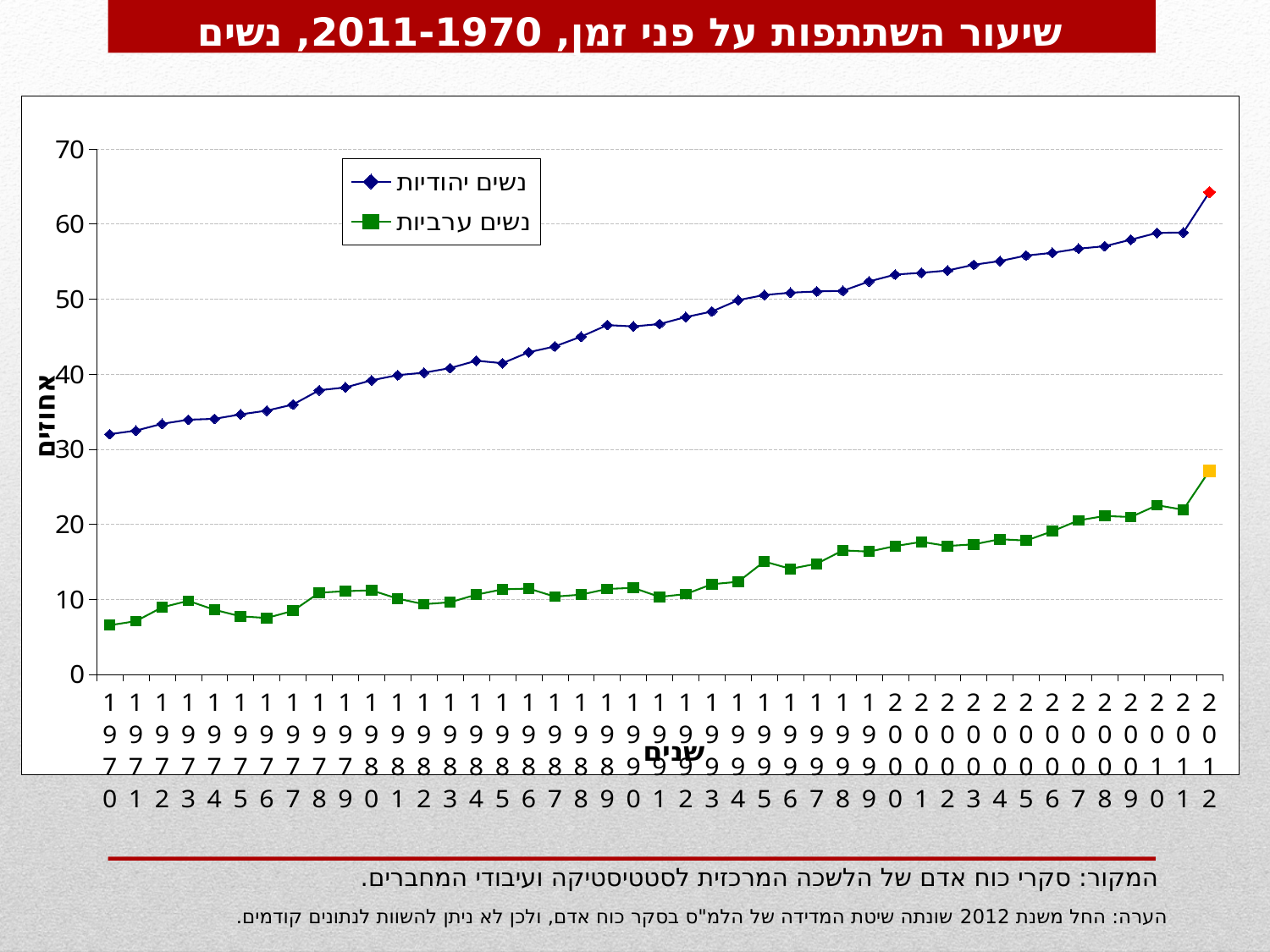
What kind of chart is shown on the slide? Line chart In 2012, which series has the larger value, נשים יהודיות or נשים ערביות? נשים יהודיות How many years (data points per series) are plotted along the x axis? 43 What is the title of the chart? שיעור השתתפות על פני זמן, 1970-2011, נשים Does the value for נשים ערביות generally rise or fall from 1970 to 2012? Rises How many series does the legend list? 2 In which year is the value for נשים יהודיות highest? 2012 Does the value for נשים יהודיות rise or fall from 1970 to 2012? Rises Is the value for נשים ערביות in 2012 greater or less than 20? greater Is the value for נשים יהודיות in 2012 greater or less than 60? greater Is the value for נשים ערביות in 1970 greater or less than 10? less What are the two series named in the legend? נשים יהודיות and נשים ערביות